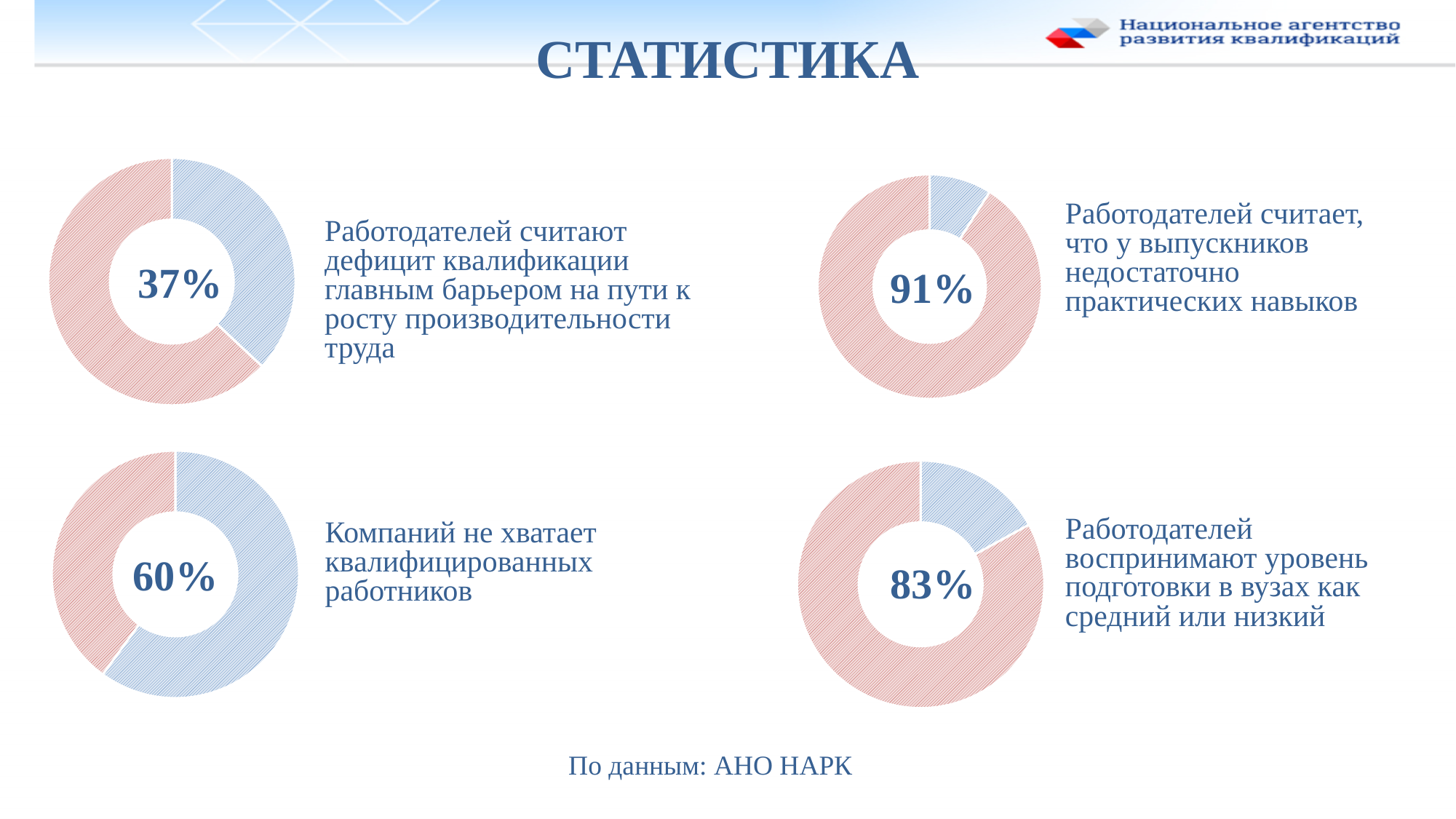
What type of chart is used on the slide to show the statistics? Donut (pie) chart What is the difference between the percentage on the top-right donut chart (91%) and the percentage on the bottom-right donut chart (83%)? 8 percentage points Which of the four donut charts on the slide shows the highest percentage? 91% (employers who believe graduates lack practical skills) Which is larger: the percentage on the bottom-right donut chart or the percentage on the bottom-left donut chart? The bottom-right chart (83%) On the top-right donut chart, what share of employers believe graduates lack sufficient practical skills? 91% Which of the four donut charts on the slide shows the lowest percentage? 37% (employers who consider the qualification deficit the main barrier to productivity growth) According to the note at the bottom of the slide, what is the source of the data? АНО НАРК On the top-left donut chart, what share of employers consider the qualification deficit the main barrier to productivity growth? 37% On the bottom-right donut chart, what share of employers perceive the level of university training as average or low? 83% How many donut charts are shown on the slide? 4 What is the difference between the percentage on the bottom-left donut chart (60%) and the percentage on the top-left donut chart (37%)? 23 percentage points On the bottom-left donut chart, what share of companies lack qualified workers? 60%